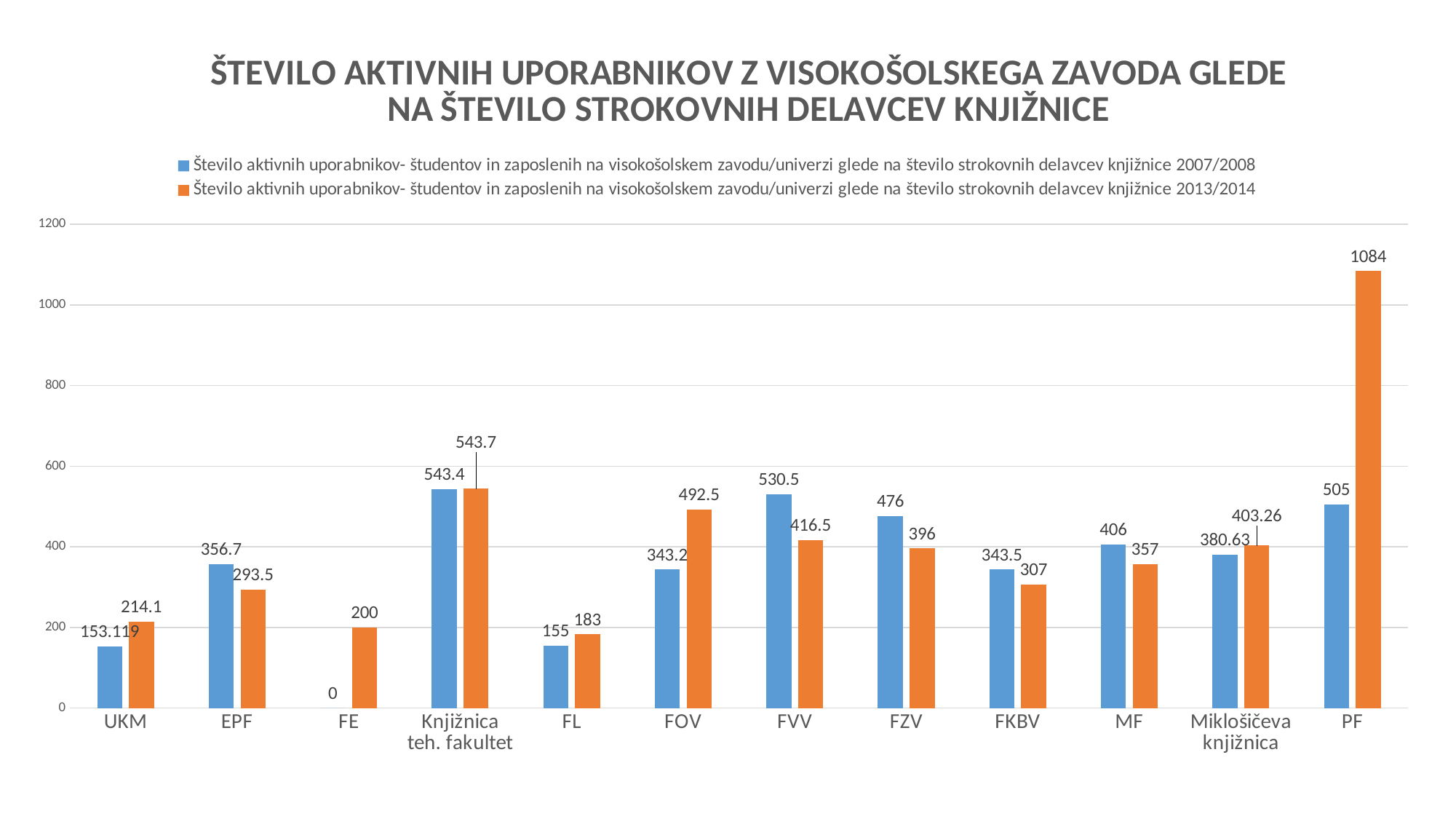
What is the value for PF in the 2013/2014 series? 1084 What is the difference between the 2007/2008 and 2013/2014 values for FVV? 114 Which category has the highest value in the 2013/2014 series? PF How many series does the legend list? 2 How many categories are shown on the x axis? 12 For FOV, which series has the larger value, 2007/2008 or 2013/2014? 2013/2014 What kind of chart is shown on the slide? bar chart Which category has the lowest value in the 2007/2008 series? FE What is the difference between the 2013/2014 and 2007/2008 values for PF? 579 What is the value for Miklošičeva knjižnica in the 2013/2014 series? 403.26 Is the 2013/2014 value for FZV greater or less than 400? less What is the value for UKM in the 2007/2008 series? 153.119